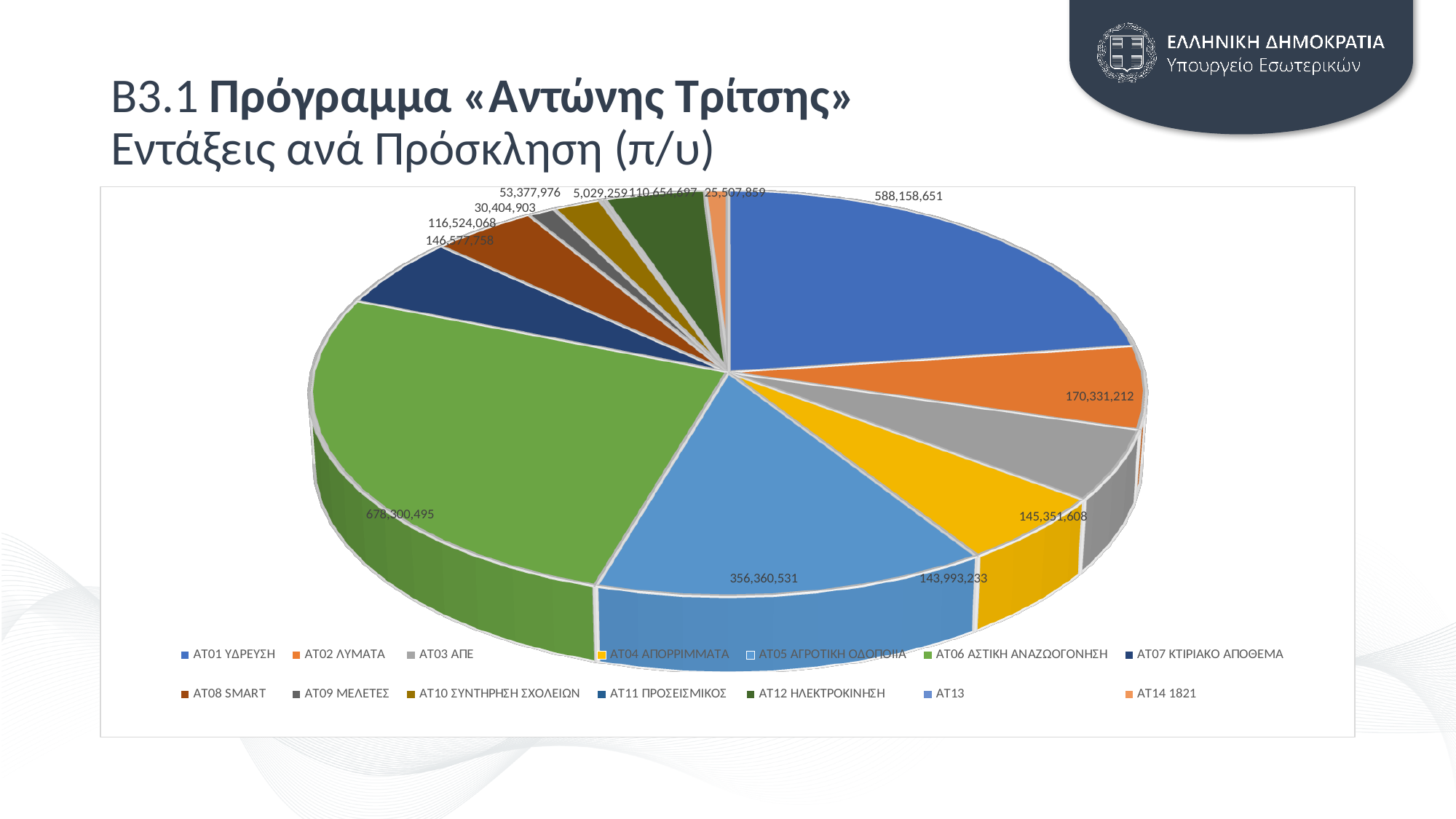
What is the value shown for AT02 ΛΥΜΑΤΑ? 170,331,212 What kind of chart is shown on the slide? Pie chart How many entries does the legend list? 14 What is the value shown for AT09 ΜΕΛΕΤΕΣ? 30,404,903 Which category has the largest slice of the pie? AT06 ΑΣΤΙΚΗ ΑΝΑΖΩΟΓΟΝΗΣΗ What is the value shown for AT01 ΥΔΡΕΥΣΗ? 588,158,651 What is the difference between the values for AT06 ΑΣΤΙΚΗ ΑΝΑΖΩΟΓΟΝΗΣΗ and AT01 ΥΔΡΕΥΣΗ? 90,141,844 What is the difference between the values for AT02 ΛΥΜΑΤΑ and AT03 ΑΠΕ? 24,979,604 Which is larger, the value for AT05 ΑΓΡΟΤΙΚΗ ΟΔΟΠΟΙΙΑ or the value for AT02 ΛΥΜΑΤΑ? AT05 ΑΓΡΟΤΙΚΗ ΟΔΟΠΟΙΙΑ What is the value shown for AT05 ΑΓΡΟΤΙΚΗ ΟΔΟΠΟΙΙΑ? 356,360,531 What is the value shown for AT06 ΑΣΤΙΚΗ ΑΝΑΖΩΟΓΟΝΗΣΗ? 678,300,495 What is the value shown for AT14 1821? 25,507,859